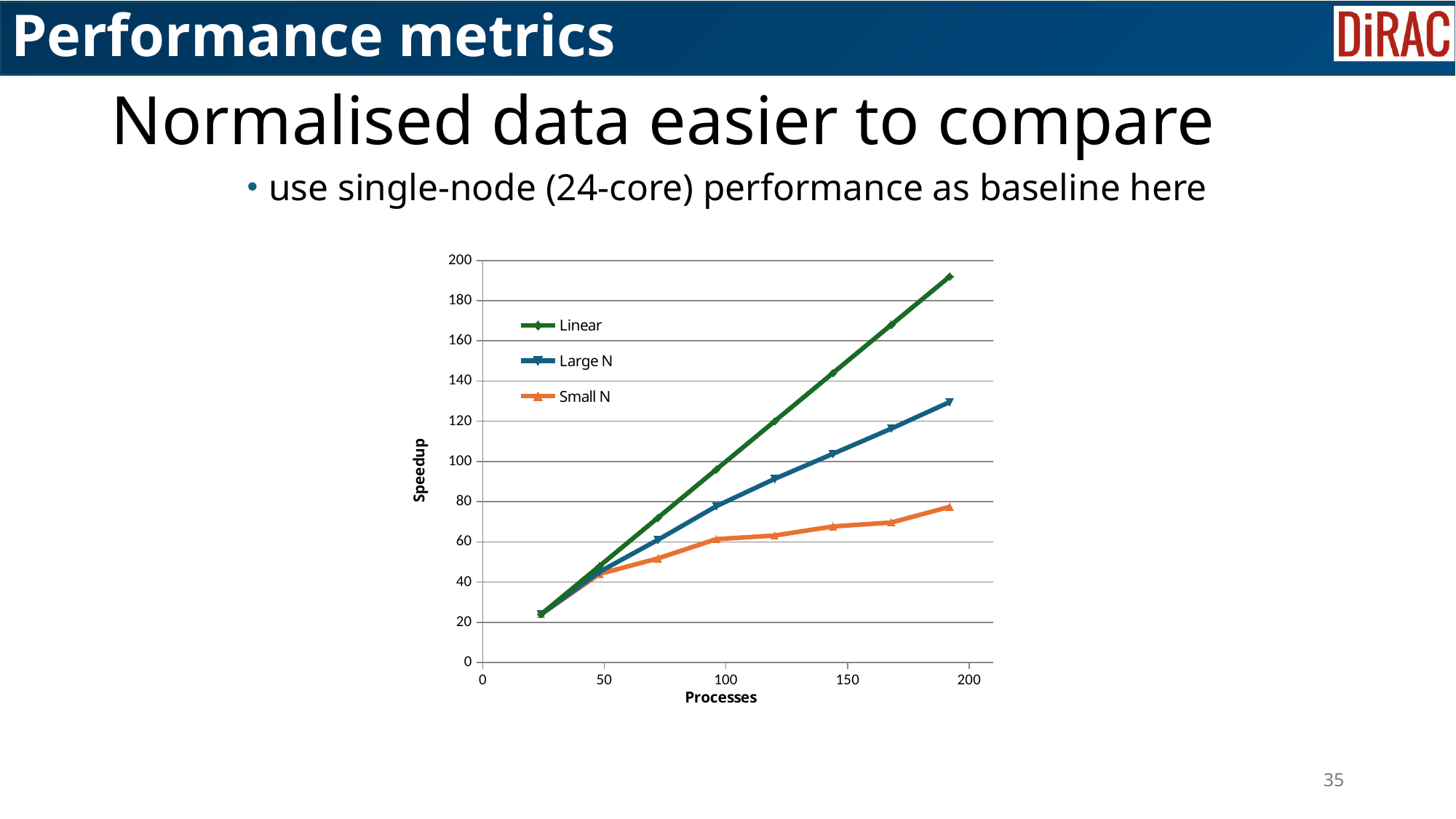
Which series has the lowest speedup at the right-hand end of the chart (around 192 processes)? Small N How many data points are plotted for the Linear series? 8 Does the speedup of the Small N series rise or fall as the number of processes increases? rises What are the x-axis and y-axis titles of the chart? Processes (x-axis) and Speedup (y-axis) Is the speedup of the Large N series at around 192 processes greater or less than 120? greater At around 192 processes, which series has the larger speedup, Large N or Small N? Large N Is the speedup of the Small N series at around 192 processes greater or less than 100? less Which series has the highest speedup at the right-hand end of the chart (around 192 processes)? Linear What kind of chart is shown on the slide? line chart How many series does the chart legend list? 3 Is the speedup of the Linear series at around 192 processes greater or less than 180? greater Which series are listed in the chart legend? Linear, Large N, Small N